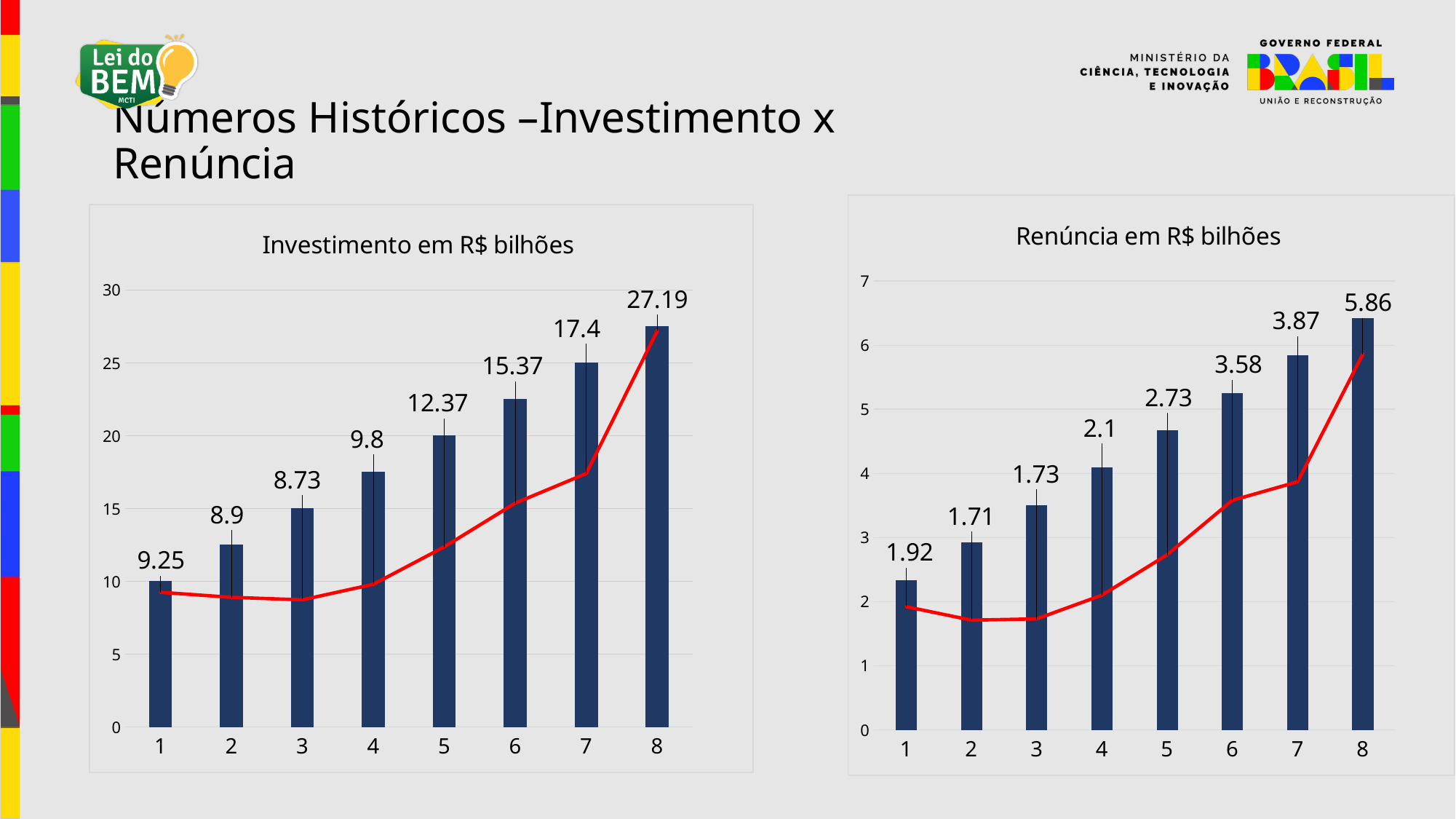
In the 'Investimento em R$ bilhões' chart, what is the difference between the labelled values for category 8 and category 7? 9.79 In the 'Renúncia em R$ bilhões' chart, what is the value labelled for category 1? 1.92 In the 'Renúncia em R$ bilhões' chart, do the labelled values generally rise or fall from category 3 to category 8? rise In the 'Investimento em R$ bilhões' chart, what is the value labelled for category 5? 12.37 In the 'Renúncia em R$ bilhões' chart, which labelled value is larger, category 4 or category 5? category 5 In the 'Renúncia em R$ bilhões' chart, what is the value labelled for category 6? 3.58 What kind of chart is the 'Investimento em R$ bilhões' chart? bar chart with a line In the 'Investimento em R$ bilhões' chart, how many categories are shown on the x axis? 8 In the 'Renúncia em R$ bilhões' chart, what is the difference between the labelled values for category 8 and category 7? 1.99 In the 'Renúncia em R$ bilhões' chart, which category has the highest labelled value? 8 In the 'Investimento em R$ bilhões' chart, which category has the lowest labelled value? 3 In the 'Investimento em R$ bilhões' chart, what is the value labelled for category 8? 27.19